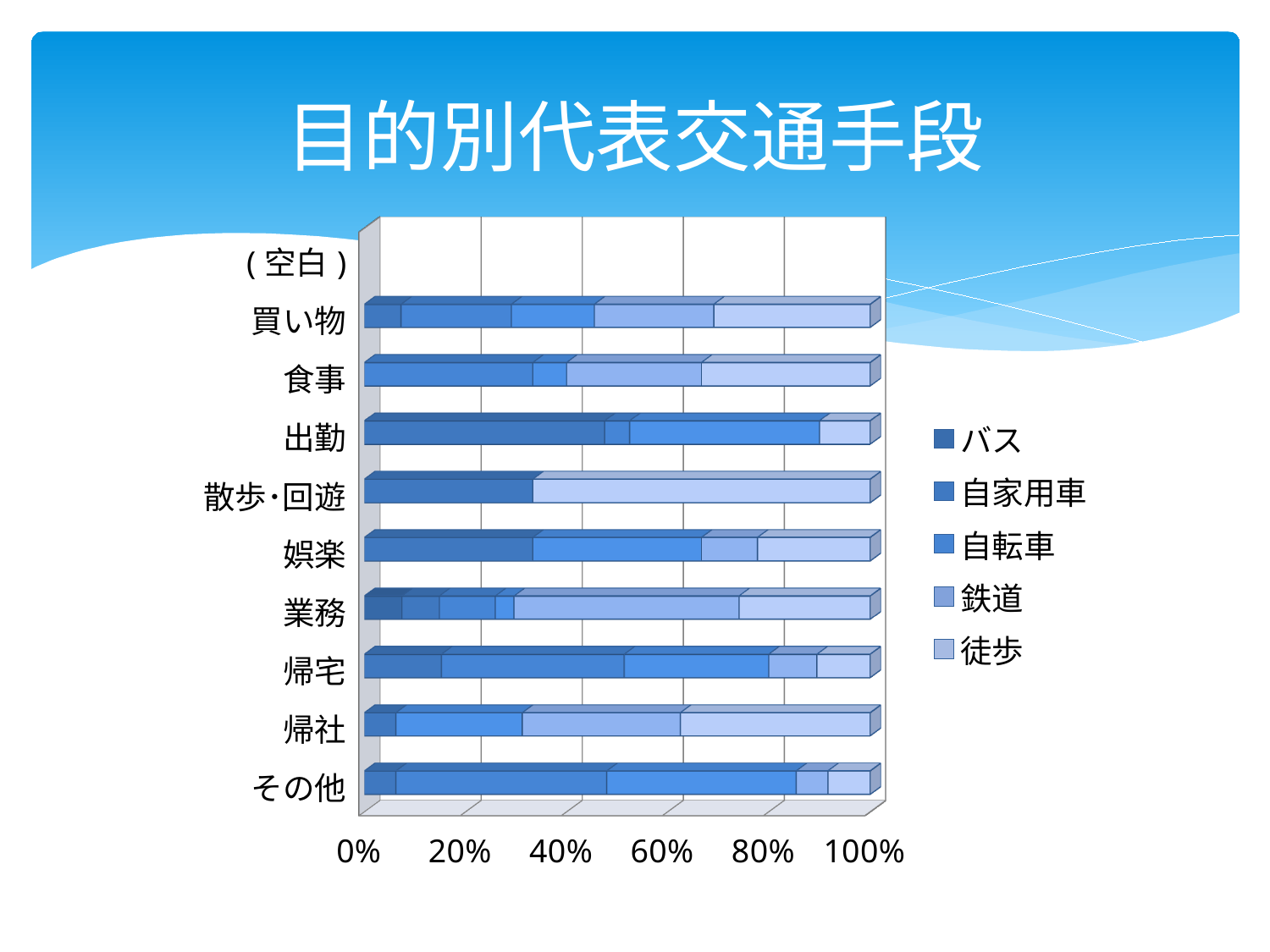
What kind of chart is shown on the slide? Stacked bar chart What value does each full stacked bar add up to on the horizontal axis? 100% How many categories are shown on the vertical axis of the chart? 10 How many series does the legend list? 5 Which has the larger 徒歩 share, 散歩・回遊 or 出勤? 散歩・回遊 Which series is listed first in the legend? バス Which category has the largest 徒歩 share? 散歩・回遊 Is the 徒歩 share for 散歩・回遊 greater or less than 60%? greater Is the 自家用車 share for 出勤 greater or less than 40%? less Is the 徒歩 share for 帰社 greater or less than 20%? greater What is the title of the chart? 目的別代表交通手段